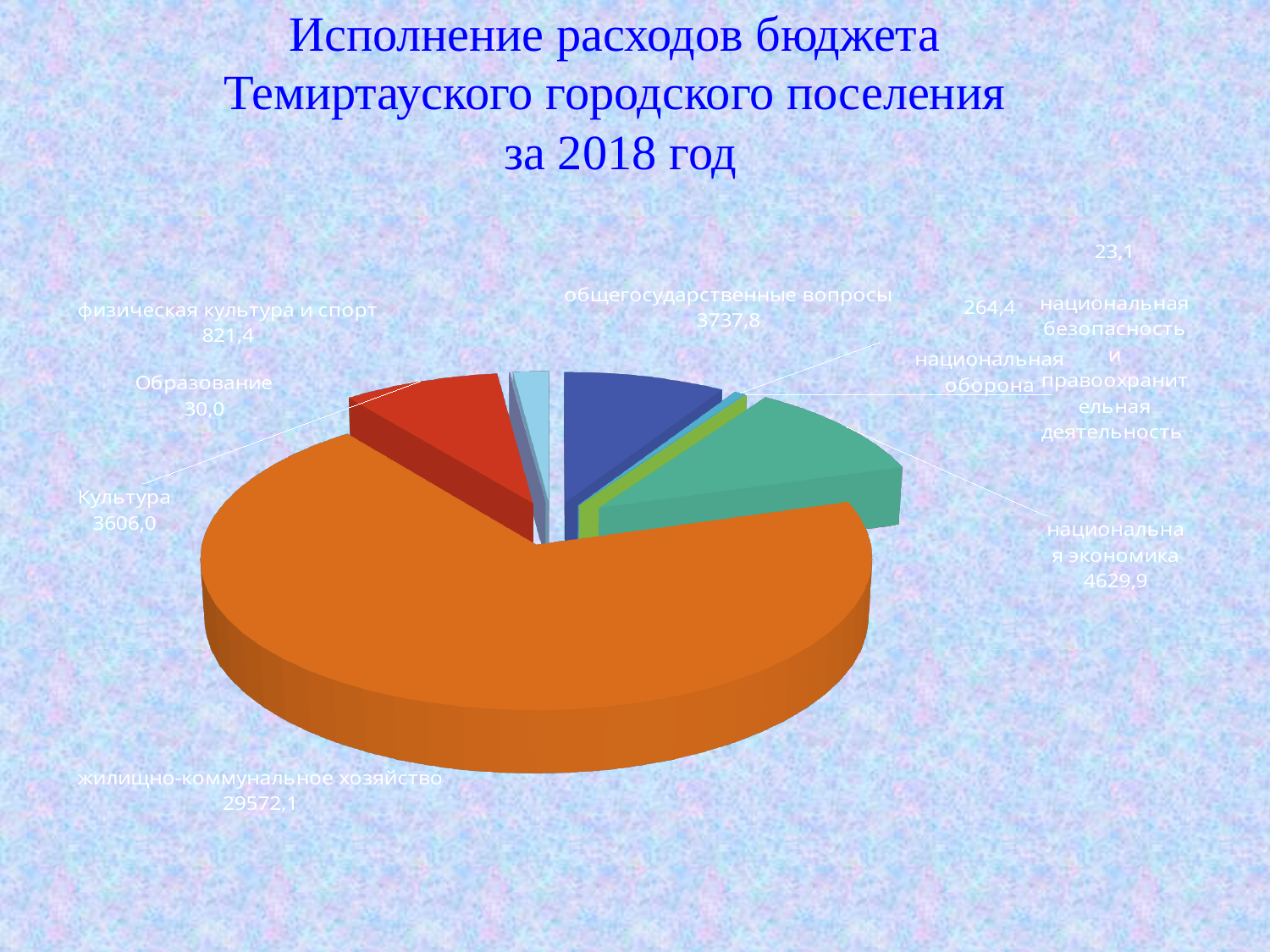
How many categories are shown in the pie chart? 8 What is the value for жилищно-коммунальное хозяйство? 29572,1 What is the value for физическая культура и спорт? 821,4 What is the difference between the values for национальная экономика and общегосударственные вопросы? 892,1 What is the value for общегосударственные вопросы? 3737,8 What year does the chart title say the budget expenditure data is for? 2018 Which is larger: the value for Культура or the value for общегосударственные вопросы? общегосударственные вопросы What kind of chart is shown on the slide? pie chart What is the value for национальная экономика? 4629,9 What is the value for национальная оборона? 264,4 Which category has the largest slice of the pie? жилищно-коммунальное хозяйство Which category has the smallest value? национальная безопасность и правоохранительная деятельность